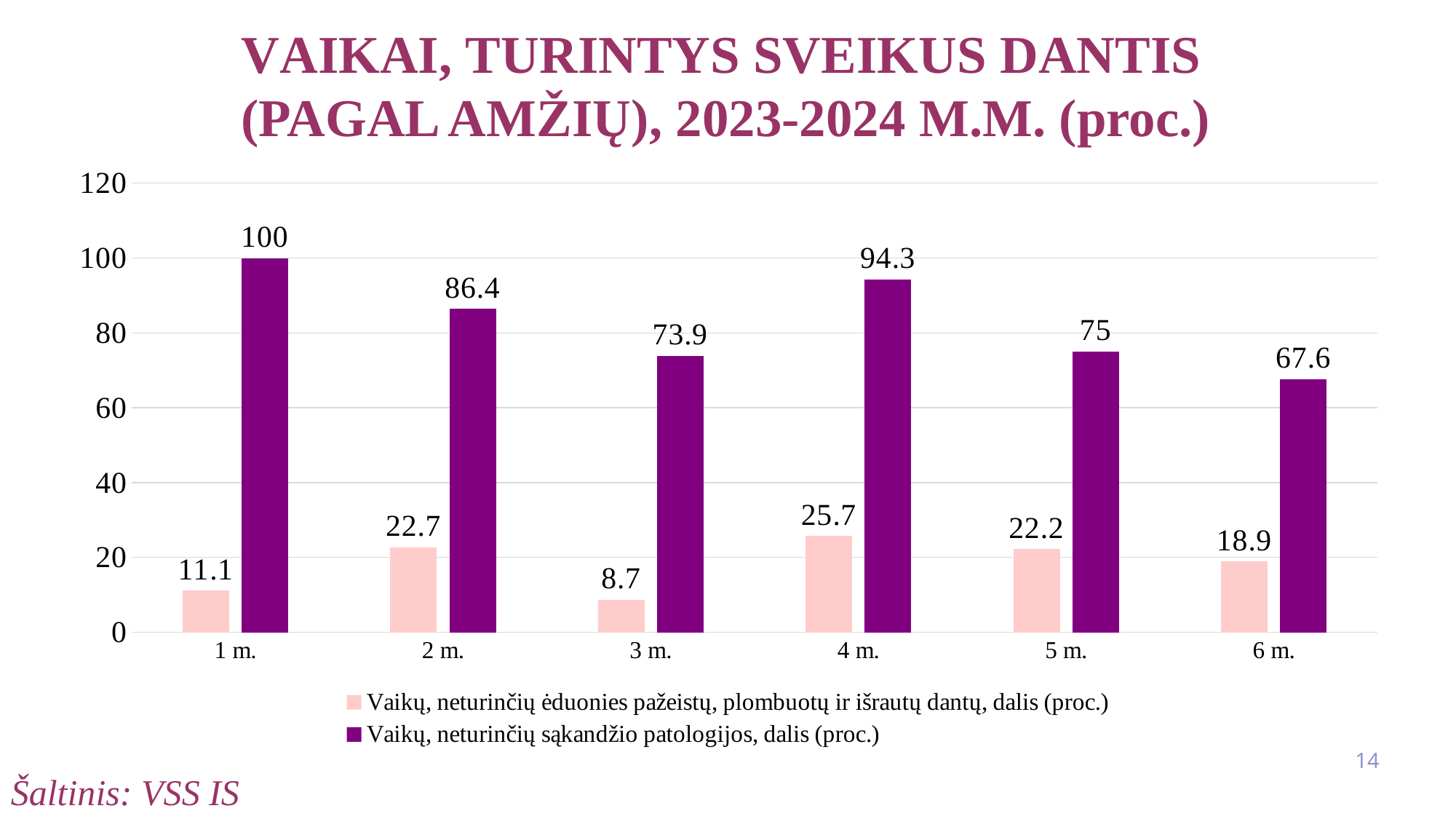
What is the value for 4 m. in the series 'Vaikų, neturinčių sąkandžio patologijos, dalis (proc.)'? 94.3 Is the value for 5 m. in the series 'Vaikų, neturinčių sąkandžio patologijos, dalis (proc.)' greater or less than 80? less Do the values in the series 'Vaikų, neturinčių sąkandžio patologijos, dalis (proc.)' rise or fall from 4 m. to 6 m.? fall How many age groups are shown on the x axis? 6 Which age group has the highest value in the series 'Vaikų, neturinčių sąkandžio patologijos, dalis (proc.)'? 1 m. Which age group has the lowest value in the series 'Vaikų, neturinčių ėduonies pažeistų, plombuotų ir išrautų dantų, dalis (proc.)'? 3 m. Which is larger in the series 'Vaikų, neturinčių ėduonies pažeistų, plombuotų ir išrautų dantų, dalis (proc.)': the value for 2 m. or the value for 5 m.? 2 m. What source is cited at the bottom of the slide? VSS IS How many series does the legend list? 2 What is the value for 3 m. in the series 'Vaikų, neturinčių ėduonies pažeistų, plombuotų ir išrautų dantų, dalis (proc.)'? 8.7 What is the difference between the two series' values for 6 m.? 48.7 What kind of chart is shown on the slide? bar chart